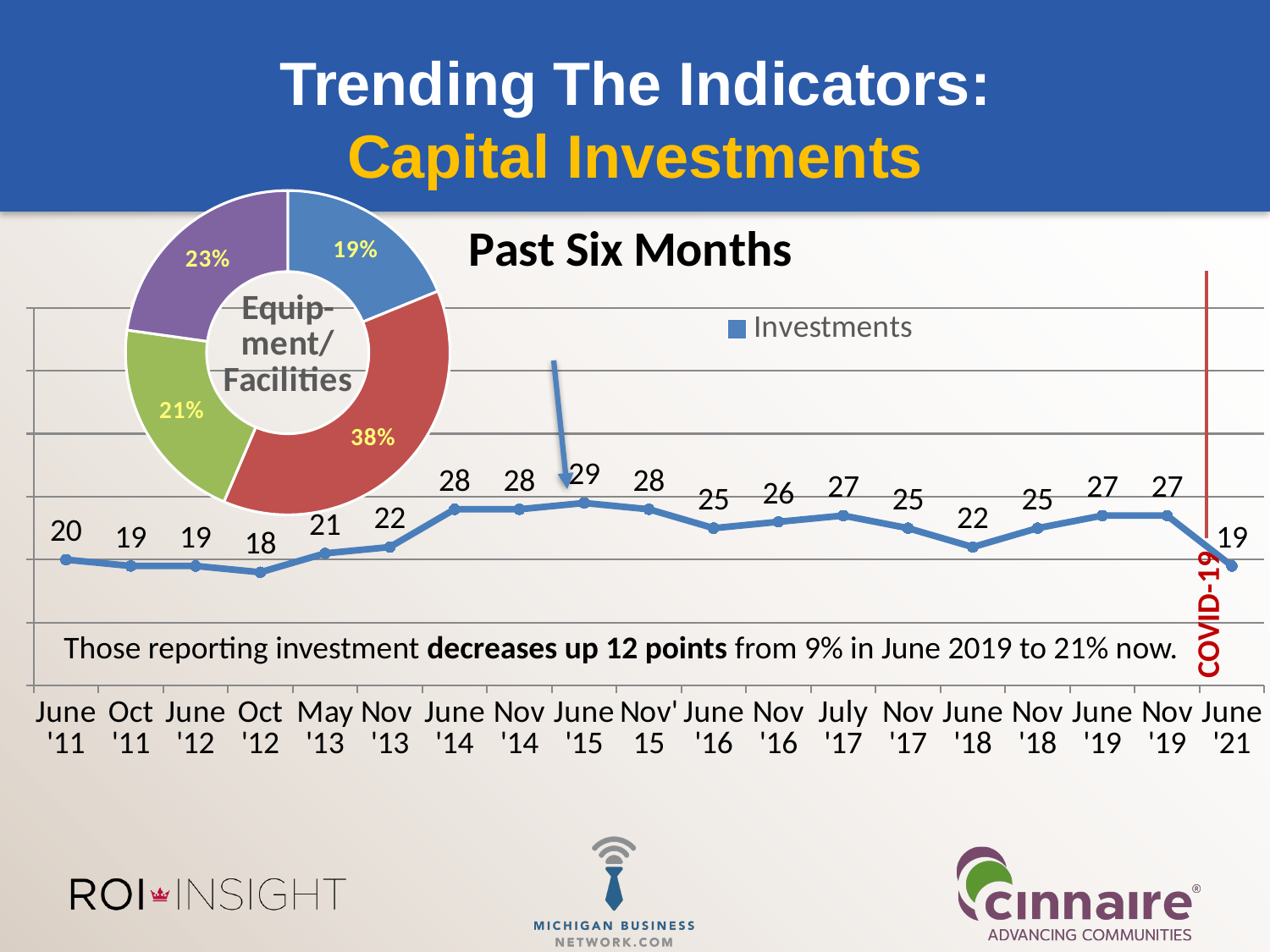
In the 'Past Six Months' line chart, what is the difference between the values for Nov '19 and June '21? 8 In the 'Past Six Months' line chart, which is larger: the value for June '14 or the value for June '18? June '14 In the 'Equipment/Facilities' donut chart, what is the largest share shown? 38% In the 'Past Six Months' line chart, what is the value for June '21? 19 In the 'Past Six Months' line chart, what is the value for June '15? 29 How many series does the legend of the 'Past Six Months' chart list? 1 In the 'Equipment/Facilities' donut chart, what share does the blue slice represent? 19% In the 'Past Six Months' line chart, what is the value for Oct '12? 18 In the 'Past Six Months' line chart, which period has the lowest value? Oct '12 What type of chart is the 'Past Six Months' chart? Line chart In the 'Past Six Months' line chart, which period has the highest value? June '15 How many data points are plotted in the 'Past Six Months' line chart? 19